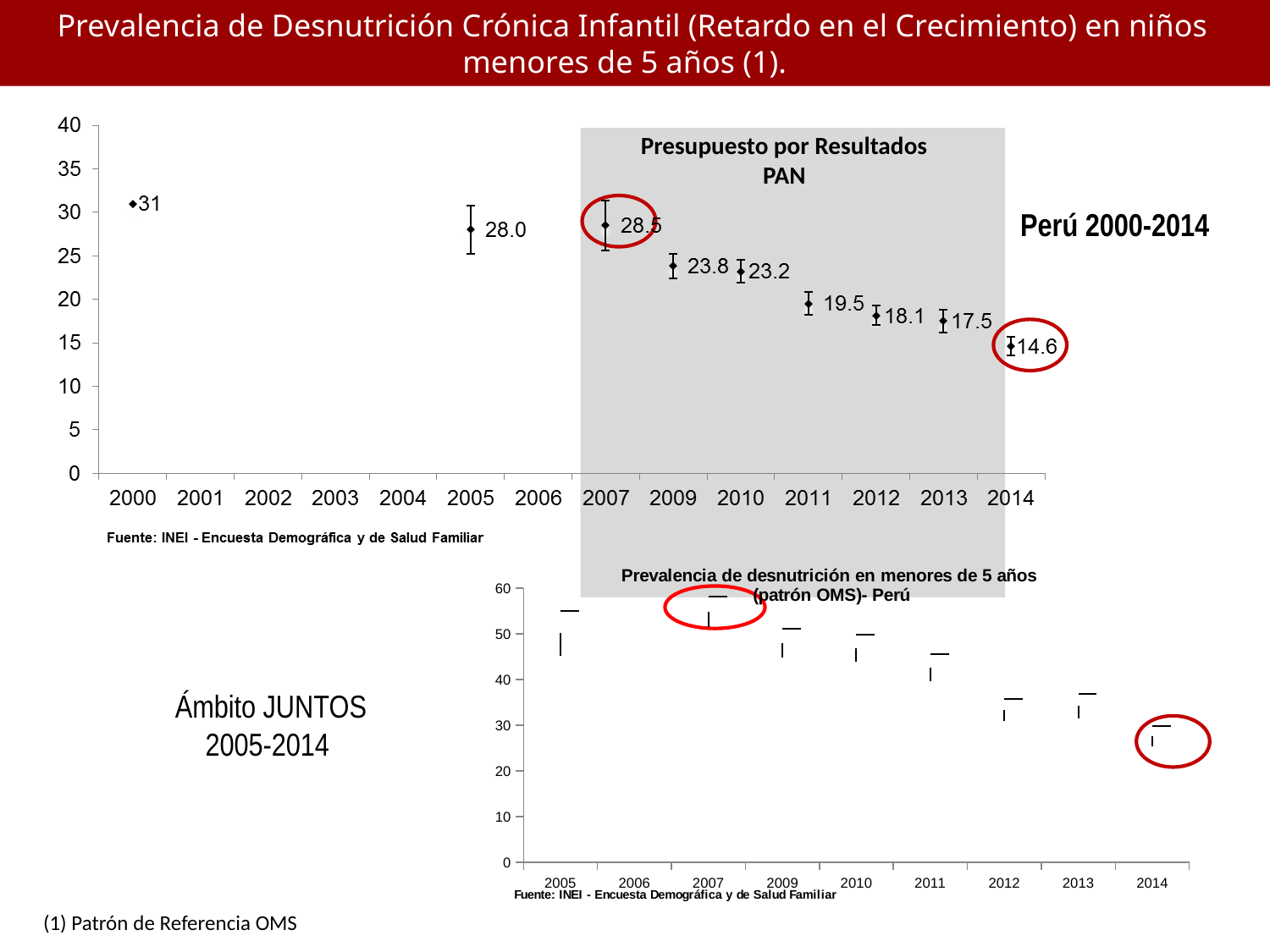
In the top chart, what is the label of the shaded region covering 2007 to 2014? Presupuesto por Resultados PAN In the top chart (Perú 2000-2014), what is the value for 2000? 31 In the bottom chart (Ámbito JUNTOS 2005-2014), is the value for 2014 greater or less than 40? less In the top chart (Perú 2000-2014), which year has the lowest value? 2014 In the top chart (Perú 2000-2014), what is the difference between the values for 2007 and 2014? 13.9 In the top chart (Perú 2000-2014), which is larger, the value for 2005 or the value for 2007? 2007 In the top chart (Perú 2000-2014), do the values generally rise or fall from 2007 to 2014? fall In the top chart (Perú 2000-2014), which year has the highest value? 2000 In the top chart (Perú 2000-2014), how many years have a plotted data point? 9 In the top chart (Perú 2000-2014), what is the value for 2014? 14.6 In the top chart (Perú 2000-2014), what is the value for 2011? 19.5